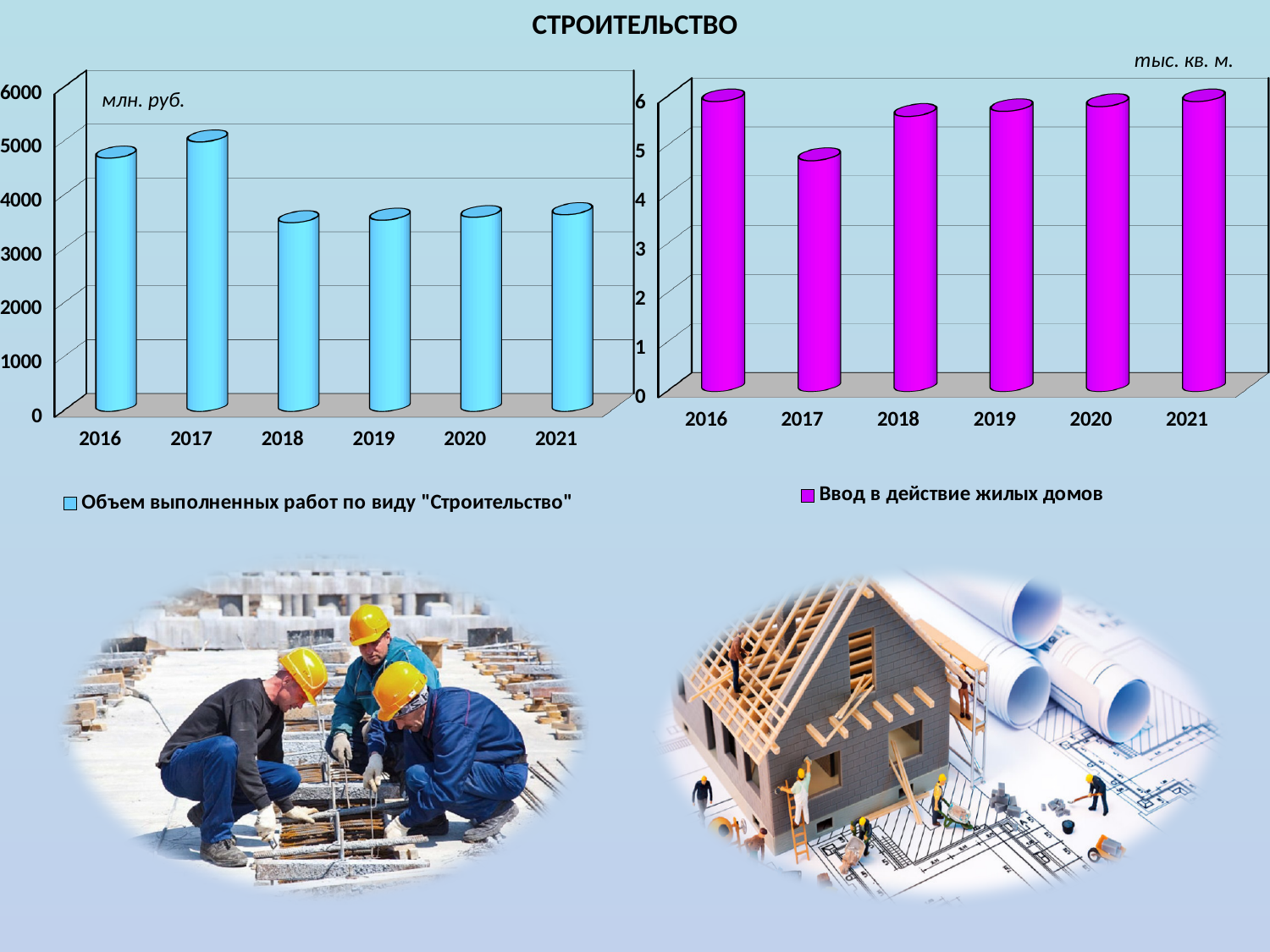
In the left chart, which year has the larger value, 2017 or 2018? 2017 What unit is shown on the right chart, "Ввод в действие жилых домов"? тыс. кв. м. In the right chart, is the value for 2017 greater or less than 5? less In the right chart, is the value for 2019 greater or less than 5? greater In the left chart, is the value for 2017 greater or less than 4000? greater In the right chart, "Ввод в действие жилых домов", which year has the highest value? 2016 and 2021 How many years are shown on the x axis of the right chart, "Ввод в действие жилых домов"? 6 In the left chart, "Объем выполненных работ по виду "Строительство"", which year has the highest value? 2017 How many series does the legend of the left chart list? 1 In the right chart, "Ввод в действие жилых домов", which year has the lowest value? 2017 What kind of chart is the left chart, "Объем выполненных работ по виду "Строительство""? bar chart